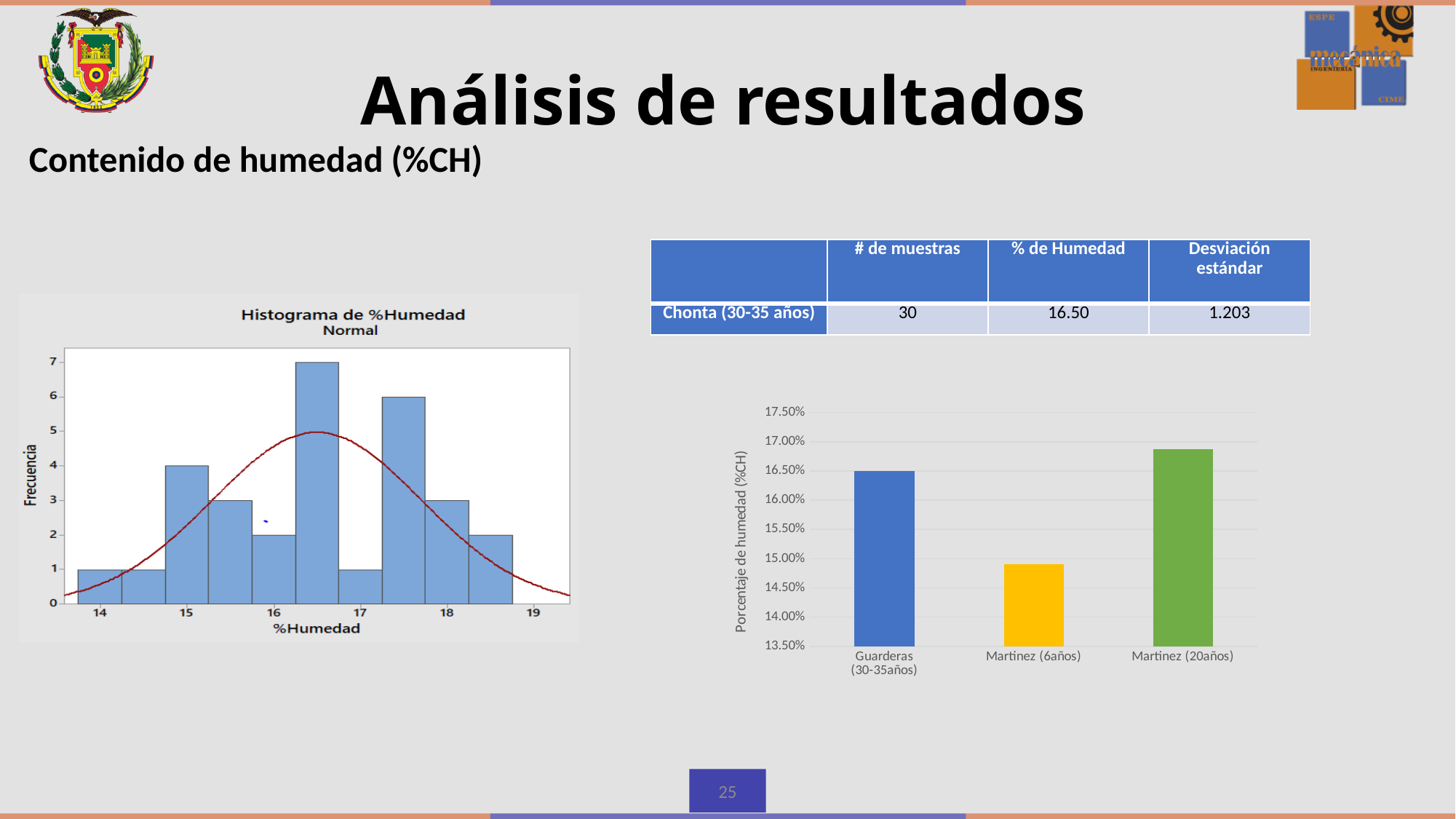
In the histogram on the left, what is the highest frequency reached by any bar? 7 In the bar chart on the right, is the value for Martinez (6años) greater or less than 15.00%? less In the bar chart on the right, is the value for Martinez (20años) greater or less than 16.50%? greater In the bar chart on the right, how many categories are shown? 3 In the bar chart on the right, is the value for Guarderas (30-35años) greater or less than 16.00%? greater What kind of chart is the chart on the right side of the slide? bar chart In the bar chart on the right, which is larger: the value for Guarderas (30-35años) or Martinez (6años)? Guarderas (30-35años) What is the title of the chart on the left side of the slide? Histograma de %Humedad Normal In the bar chart on the right, which category has the highest percentage of humidity? Martinez (20años) What is the y-axis label of the bar chart on the right? Porcentaje de humedad (%CH) In the bar chart on the right, which category has the lowest percentage of humidity? Martinez (6años) In the histogram on the left, how many bars are there? 10